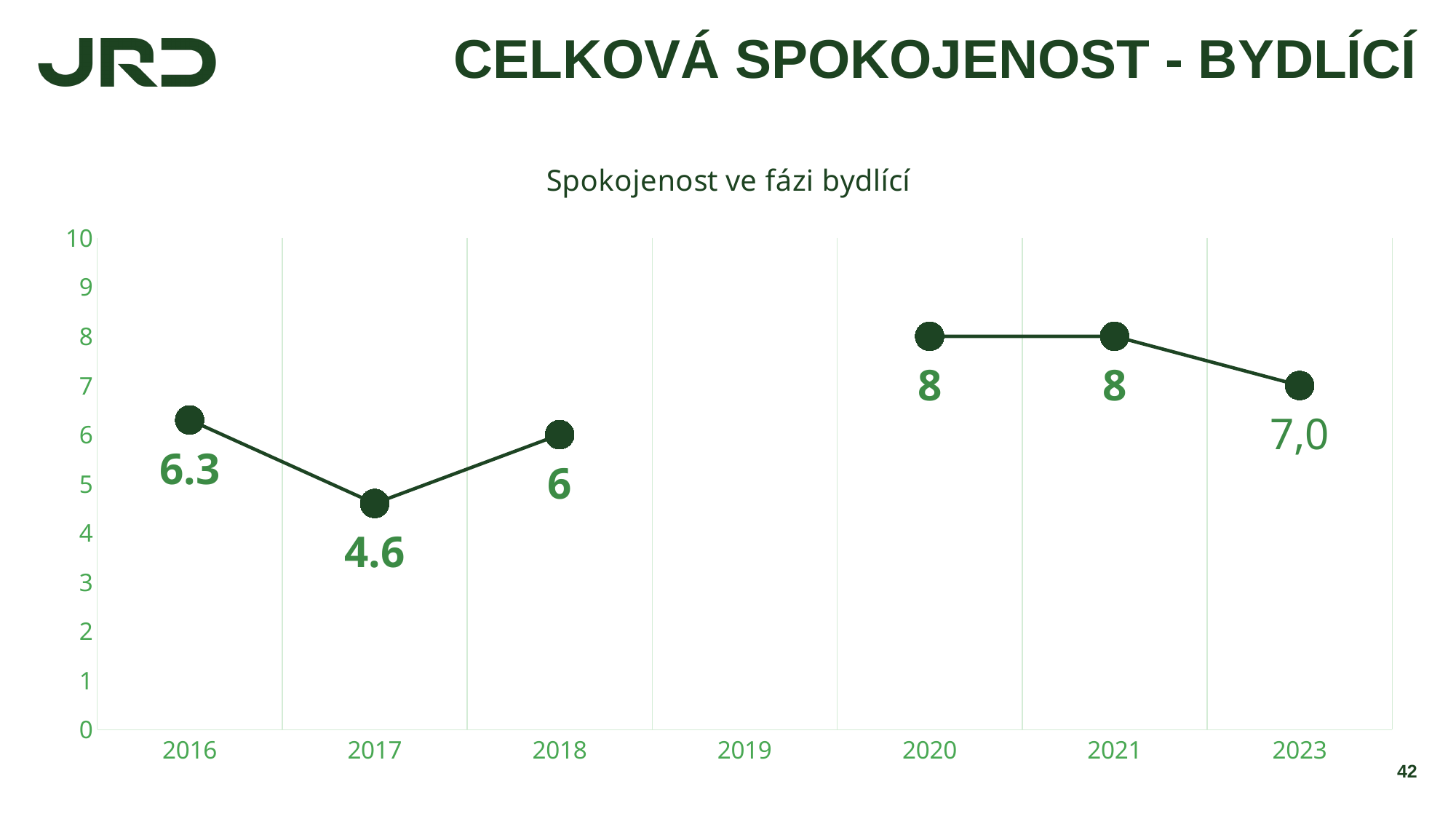
What is the highest value plotted in the chart? 8 What is the value for 2016 in the chart? 6.3 Which is larger, the value for 2018 or the value for 2023? 2023 What is the value for 2020 in the chart? 8 What kind of chart is shown on the slide? line chart What is the value for 2023 in the chart? 7,0 What is the difference between the values for 2018 and 2017? 1.4 Which year has the lowest value in the chart? 2017 What is the value for 2017 in the chart? 4.6 What is the difference between the values for 2016 and 2017? 1.7 What is the title of the chart? Spokojenost ve fázi bydlící How many years are labelled on the x axis of the chart? 7